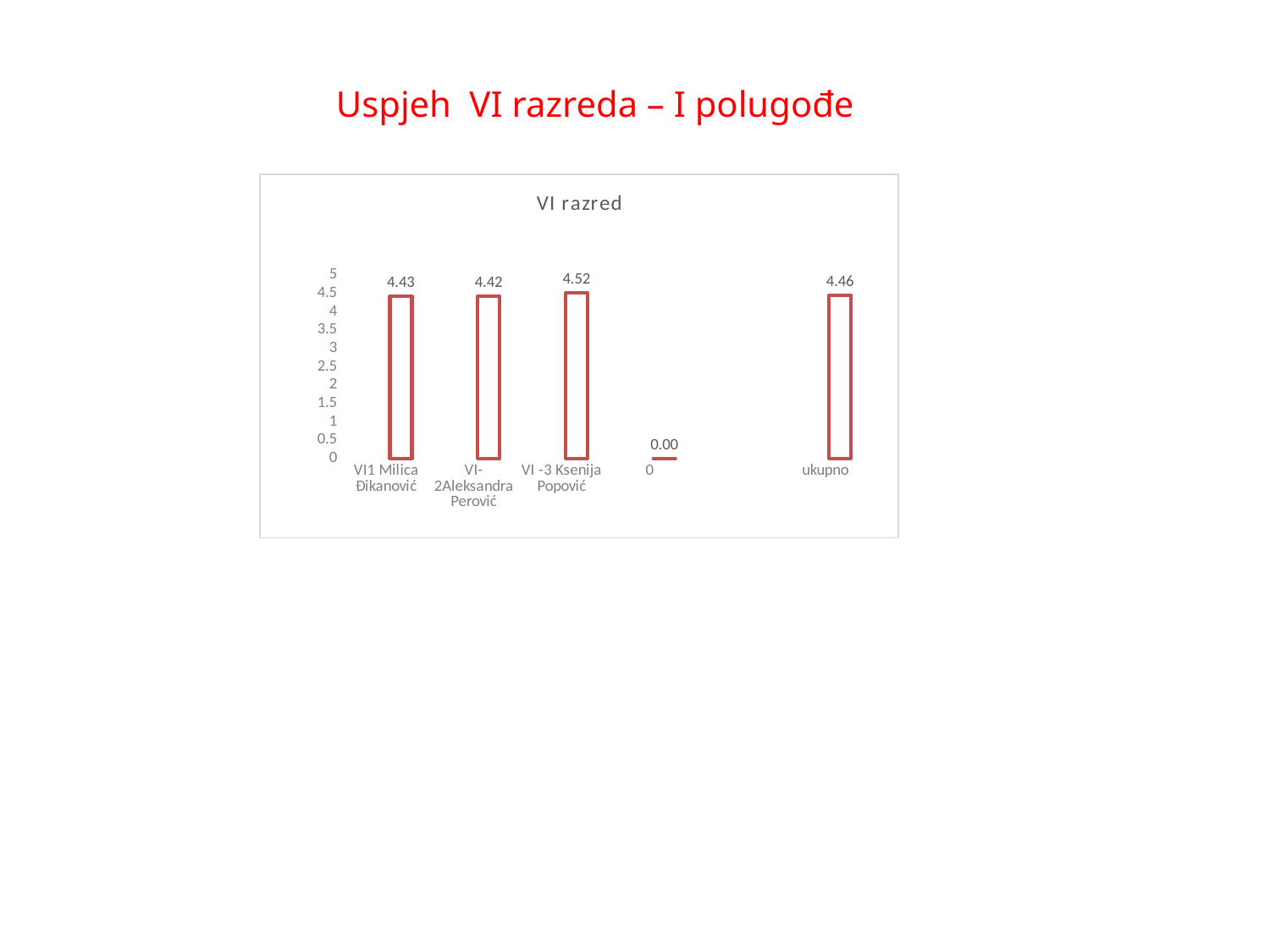
What is the difference between the values for VI -3 Ksenija Popović and VI-2 Aleksandra Perović? 0.10 What is the value shown for VI1 Milica Đikanović? 4.43 What kind of chart is shown on the slide? bar chart Which category has the lowest value in the chart? 0 What is the difference between the ukupno value and the value for VI1 Milica Đikanović? 0.03 What is the title of the chart? VI razred What is the value shown for VI-2 Aleksandra Perović? 4.42 How many categories are shown on the x axis of the chart? 5 Which is larger, the value for VI -3 Ksenija Popović or the value for VI1 Milica Đikanović? VI -3 Ksenija Popović Which category has the highest value in the chart? VI -3 Ksenija Popović What is the value shown for VI -3 Ksenija Popović? 4.52 What is the value shown for the ukupno bar? 4.46